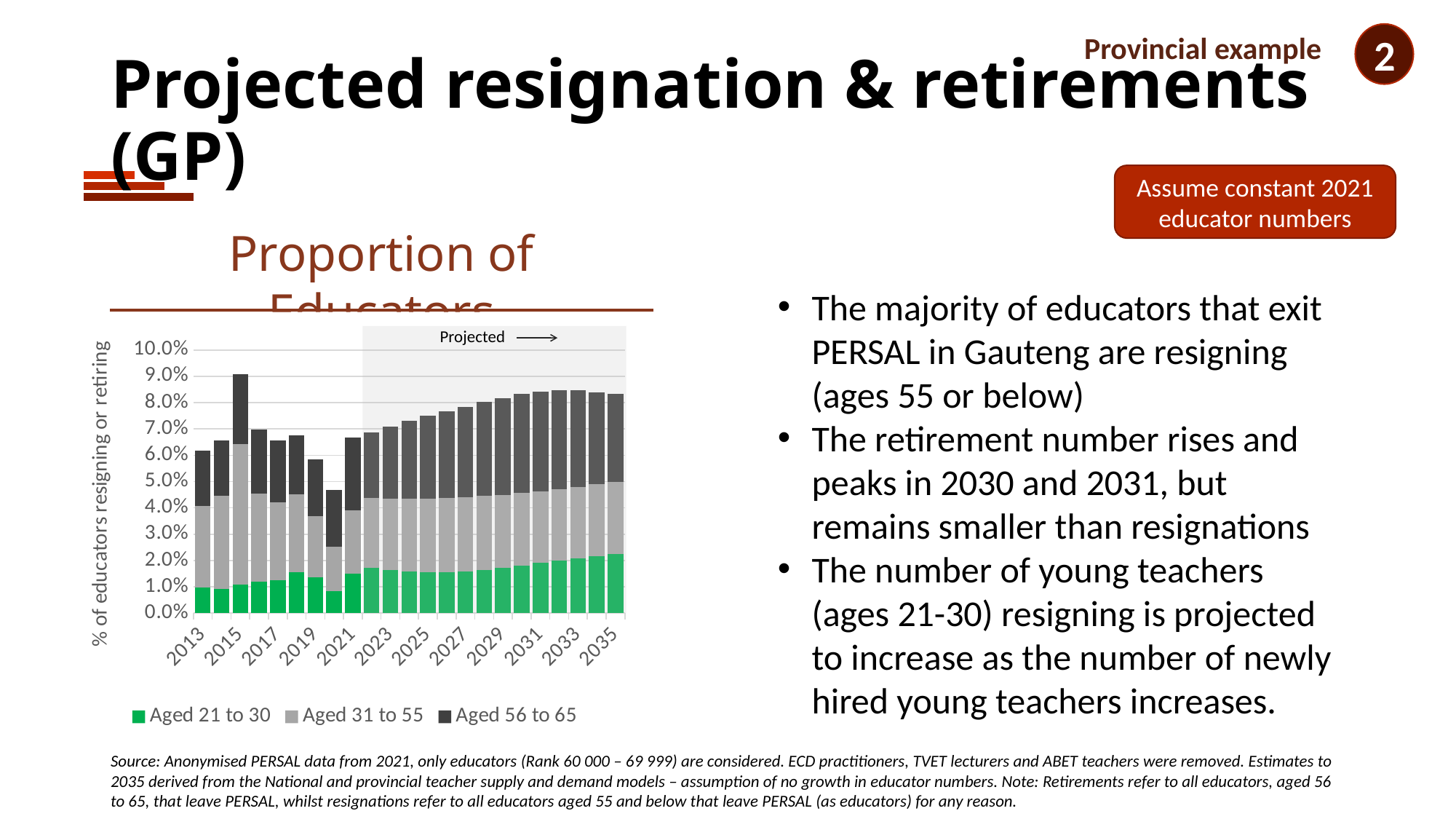
Does the total proportion rise or fall from 2022 to 2030? Rise Which year has the lowest total proportion of educators resigning or retiring? 2020 What kind of chart is shown on the slide? Stacked bar chart Which year has a larger total value, 2015 or 2016? 2015 How many years (bars) are plotted in the chart? 23 Is the total value for 2015 greater or less than 8.0%? greater Which year has the highest total proportion of educators resigning or retiring? 2015 Is the total value for 2013 greater or less than 5.0%? greater How many series does the chart legend list? 3 Is the total value for 2020 greater or less than 5.0%? less What is the label on the vertical axis of the chart? % of educators resigning or retiring What are the three series listed in the chart legend? Aged 21 to 30, Aged 31 to 55, Aged 56 to 65